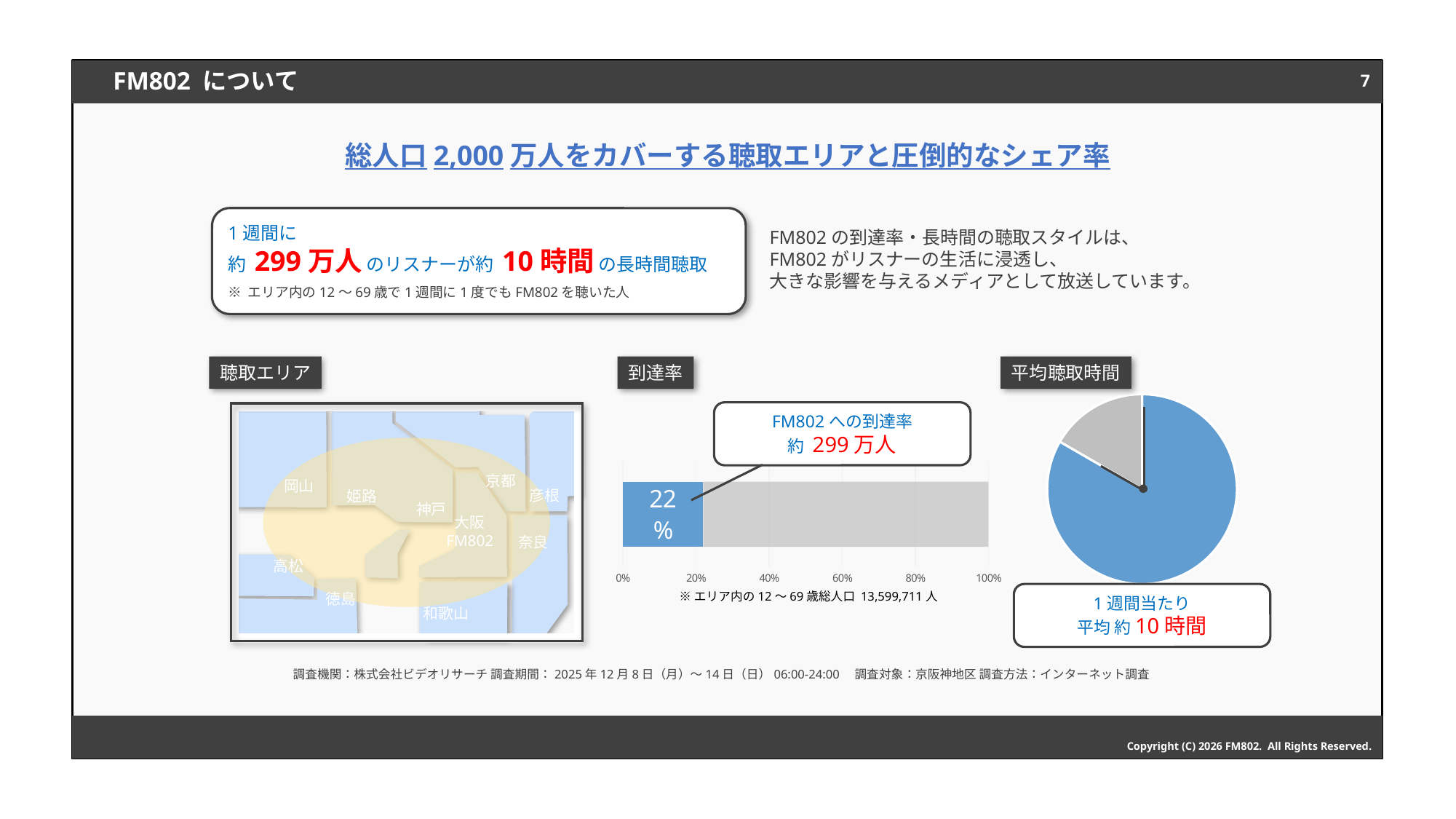
In the 到達率 bar chart, what is the highest value shown on the horizontal axis? 100% In the 到達率 bar chart, what value is printed on the blue bar? 22% What kind of chart is shown under the 到達率 heading? bar chart In the 平均聴取時間 pie chart, which slice is larger, the blue one or the gray one? the blue one In the 到達率 bar chart, what total population (12–69 years old in the area) is stated in the note below the axis? 13,599,711 人 What kind of chart is shown under the 平均聴取時間 heading? pie chart According to the callout under the 平均聴取時間 pie chart, what is the average listening time per week? 平均 約 10 時間 In the 到達率 bar chart, how many people does the callout say FM802 reaches? 約 299 万人 In the 到達率 bar chart, is the value for FM802 greater or less than 40%? less In the 到達率 bar chart, is the value for FM802 greater or less than 20%? greater In the 到達率 bar chart, how many bars are plotted? 1 How many slices does the 平均聴取時間 pie chart have? 2